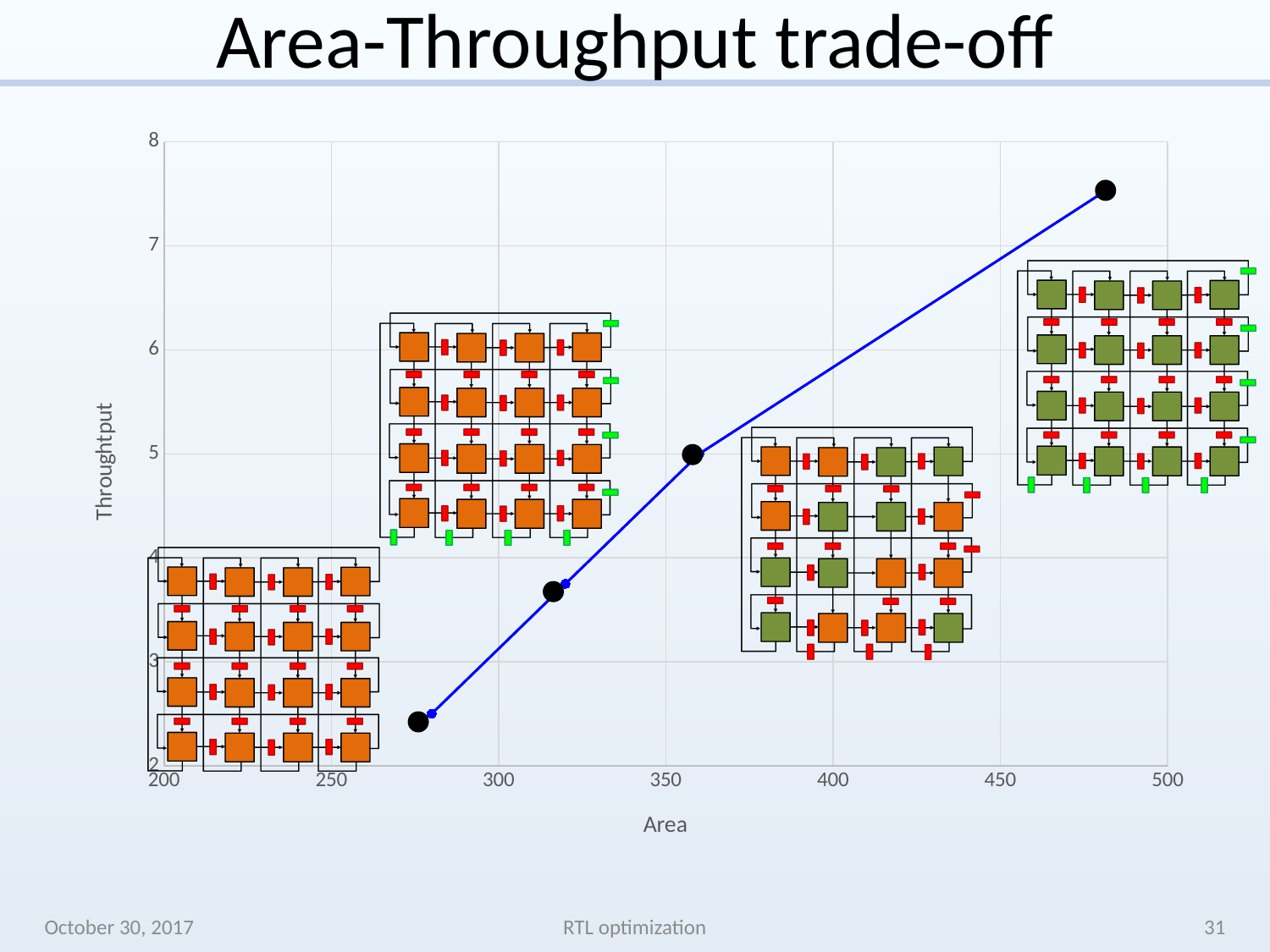
What is the title of the chart on the slide? Area-Throughput trade-off Is the area of the data point with the highest throughput greater or less than 450? greater Which data point has the higher throughput, the leftmost or the rightmost? the rightmost What is the label of the x axis? Area Is the area of the data point with the lowest throughput greater or less than 300? less What kind of chart is shown on the slide? line chart Is the throughput of the leftmost data point greater or less than 3? less Does the data point with the largest area have the highest or the lowest throughput? the highest Does throughput rise or fall as area increases along the x axis? rise How many data points are plotted on the chart? 4